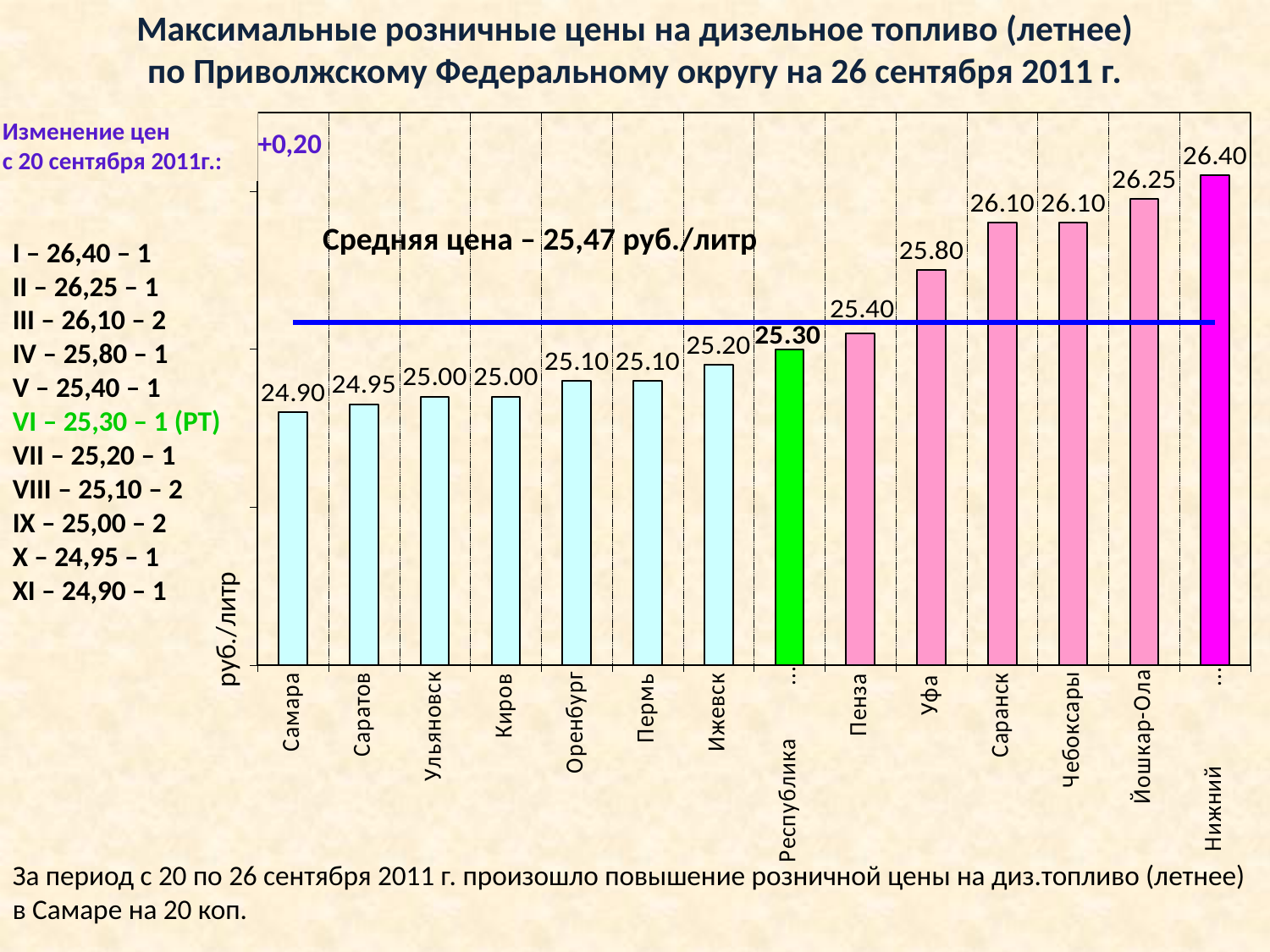
What is the difference between the values for Йошкар-Ола and Самара? 1.35 What is the value for Самара? 24.90 What kind of chart is shown on the slide? Bar chart What is the difference between the values for Уфа and Пенза? 0.40 How many bars are shown on the chart? 14 Do the values rise or fall from left to right along the x axis? Rise Which city has the lowest value on the chart? Самара What is the value for Ижевск? 25.20 Which is larger, the value for Саранск or the value for Пенза? Саранск What is the value of the rightmost (magenta) bar? 26.40 What is the value for Уфа? 25.80 What is the value for Йошкар-Ола? 26.25